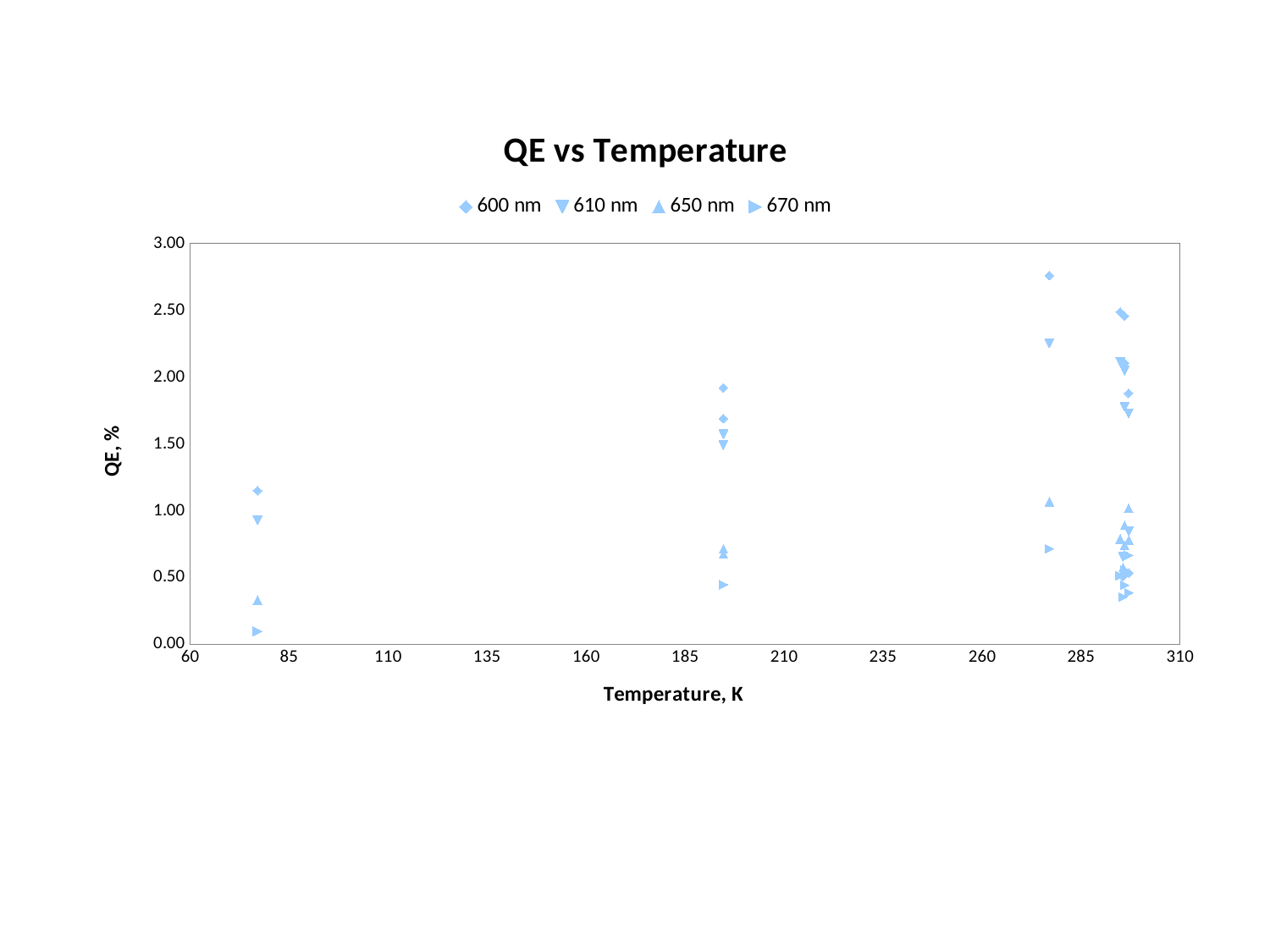
What is the title of the chart? QE vs Temperature What is the label of the x axis? Temperature, K Is the 670 nm point near 77 K greater or less than 0.50? less What kind of chart is shown on the slide? scatter chart How many series does the legend list? 4 Which series reaches the highest QE values on the chart? 600 nm Is the 610 nm point near 190 K greater or less than 1.00? greater Which series has the lowest QE values on the chart? 670 nm Is the highest 600 nm point (near 277 K) greater or less than 2.50? greater Near 190 K, which series has the larger QE, 600 nm or 650 nm? 600 nm